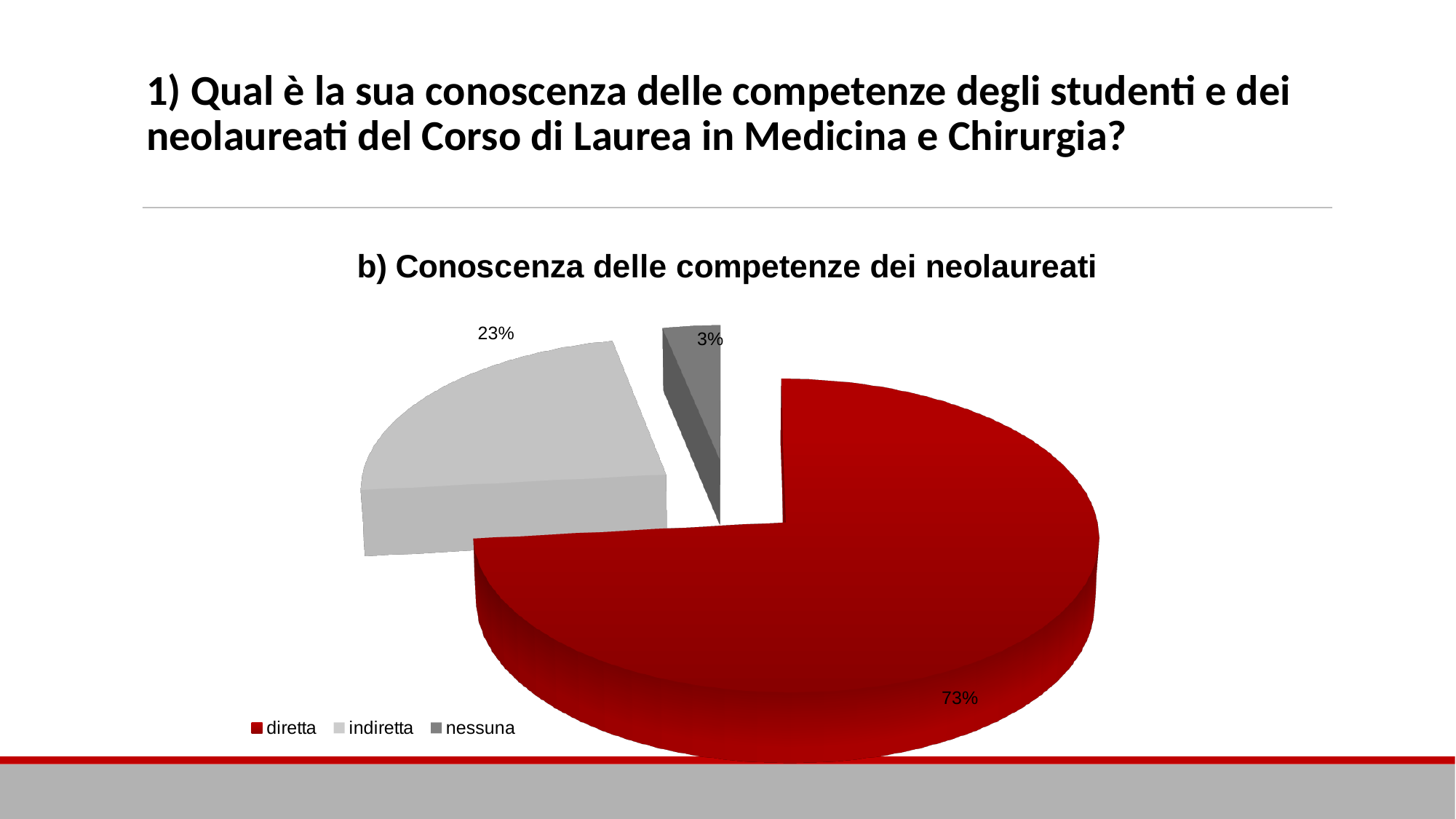
What colour is the 'diretta' slice? red Which is larger, the 'indiretta' slice or the 'nessuna' slice? indiretta What is the difference in percentage points between the 'diretta' and 'indiretta' slices? 50 What is the title of the chart? b) Conoscenza delle competenze dei neolaureati What percentage is shown for the 'indiretta' slice? 23% Which category has the smallest share of the pie? nessuna Which category has the largest share of the pie? diretta What percentage is shown for the 'nessuna' slice? 3% What percentage is shown for the 'diretta' slice? 73% What is the difference in percentage points between the 'indiretta' and 'nessuna' slices? 20 How many categories does the legend list? 3 What kind of chart is shown on the slide? pie chart